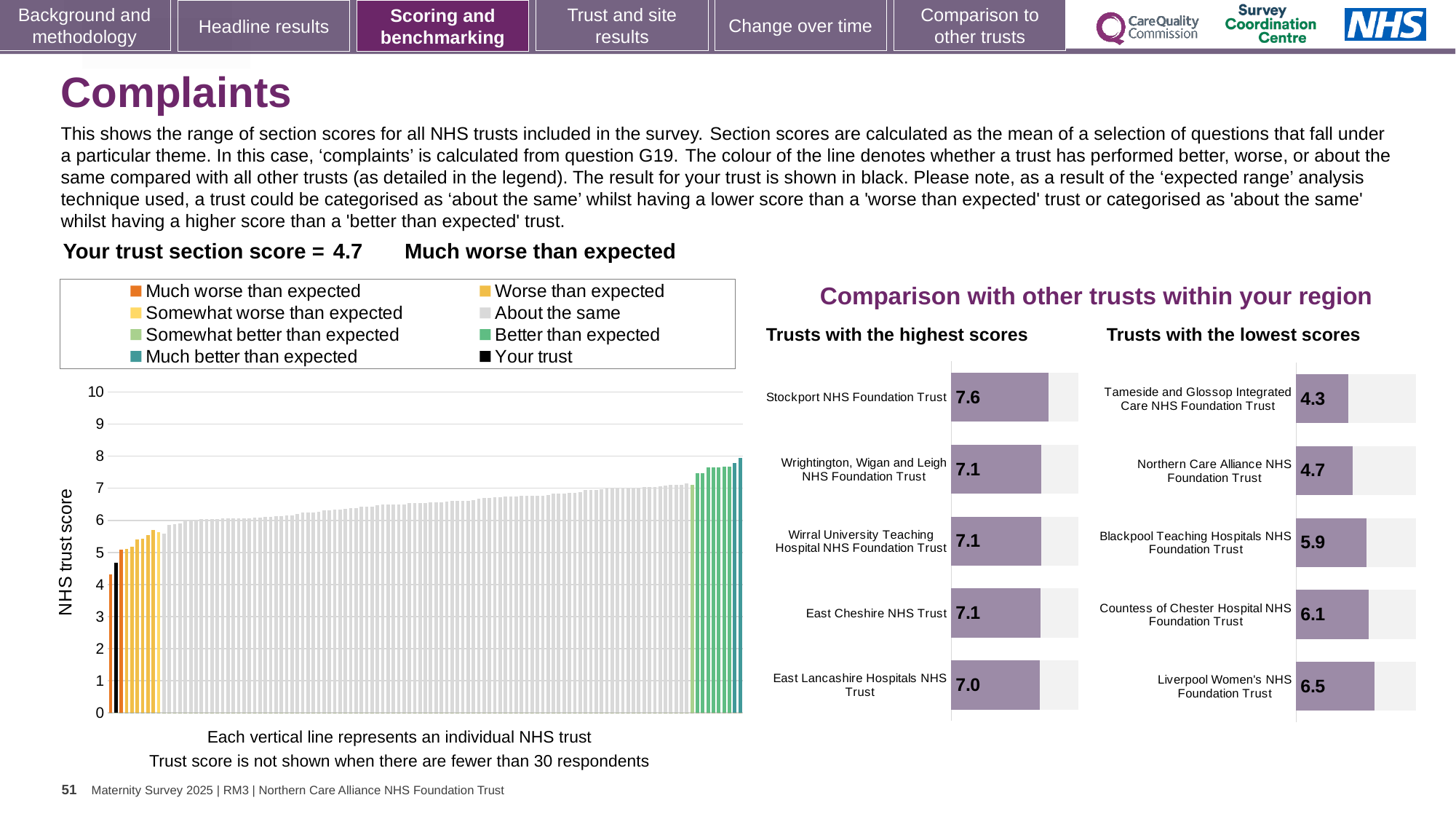
In the 'Trusts with the lowest scores' chart, which has the higher score: Countess of Chester Hospital NHS Foundation Trust or Northern Care Alliance NHS Foundation Trust? Countess of Chester Hospital NHS Foundation Trust In the main NHS trust score chart on the left, is the value for your trust (the black bar) greater or less than 5? less How many trusts are listed in the 'Trusts with the lowest scores' chart? 5 How many entries does the legend of the main NHS trust score chart list? 8 In the 'Trusts with the highest scores' chart, what is the score for Stockport NHS Foundation Trust? 7.6 In the 'Trusts with the highest scores' chart, which trust has the highest score? Stockport NHS Foundation Trust In the 'Trusts with the lowest scores' chart, what is the score for Blackpool Teaching Hospitals NHS Foundation Trust? 5.9 In the 'Trusts with the highest scores' chart, what is the difference between the scores of Stockport NHS Foundation Trust and East Lancashire Hospitals NHS Trust? 0.6 In the 'Trusts with the lowest scores' chart, which trust has the lowest score? Tameside and Glossop Integrated Care NHS Foundation Trust What kind of chart is the main NHS trust score chart on the left? bar chart In the 'Trusts with the lowest scores' chart, what is the difference between the scores of Liverpool Women's NHS Foundation Trust and Tameside and Glossop Integrated Care NHS Foundation Trust? 2.2 In the main NHS trust score chart on the left, do the values rise or fall from left to right? rise